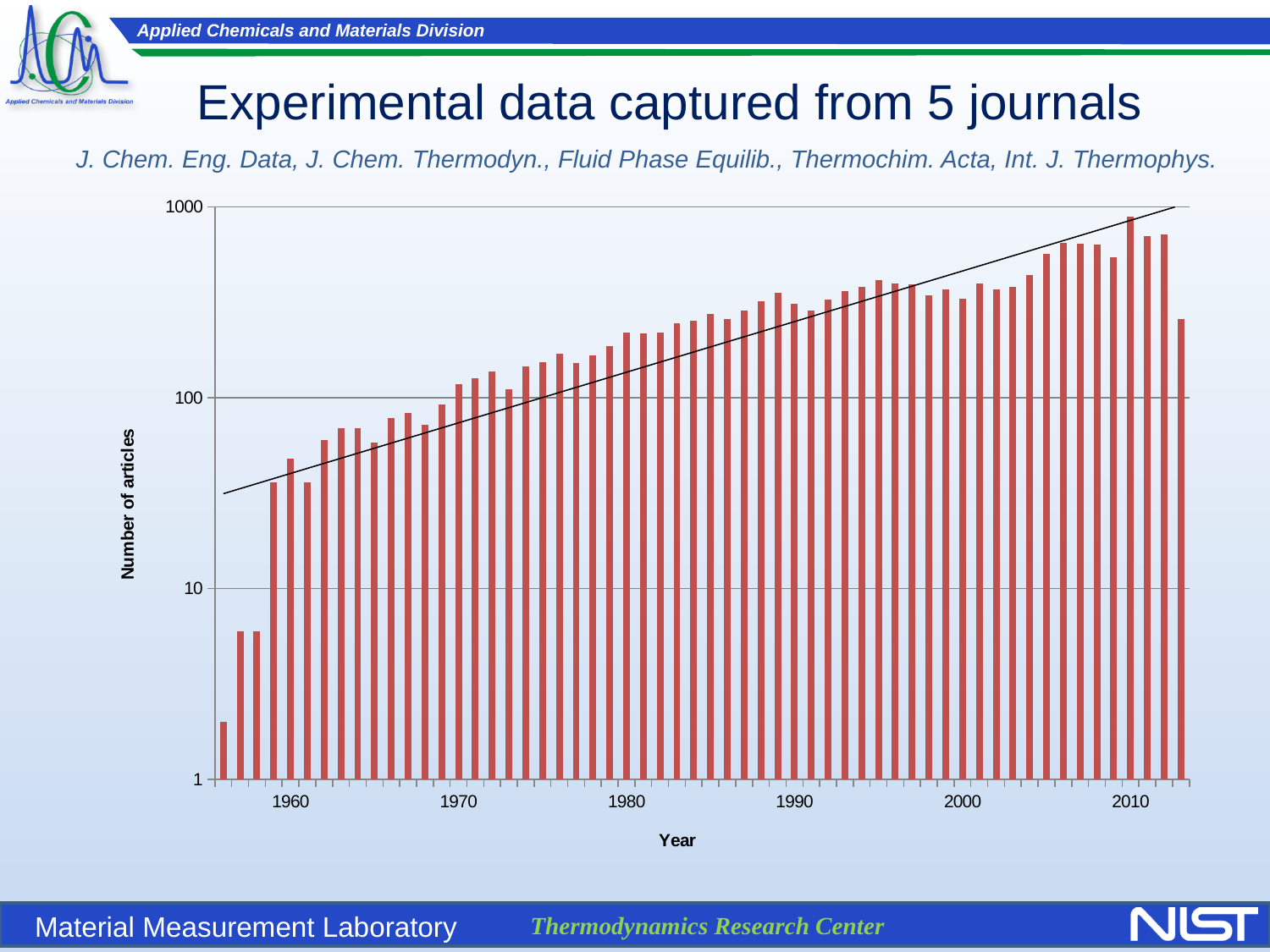
Is the number of articles for 1990 greater or less than 100? greater Is the number of articles for 2000 greater or less than 1000? less Which year has the highest number of articles? 2010 What is the label of the horizontal axis? Year Do the number of articles generally rise or fall from 1960 to 2010? rise Is the number of articles for 1960 greater or less than 100? less What kind of chart is shown on the slide? bar chart Which year has more articles, 1960 or 1980? 1980 Which year has more articles, 2000 or 2010? 2010 What is the label of the vertical axis? Number of articles